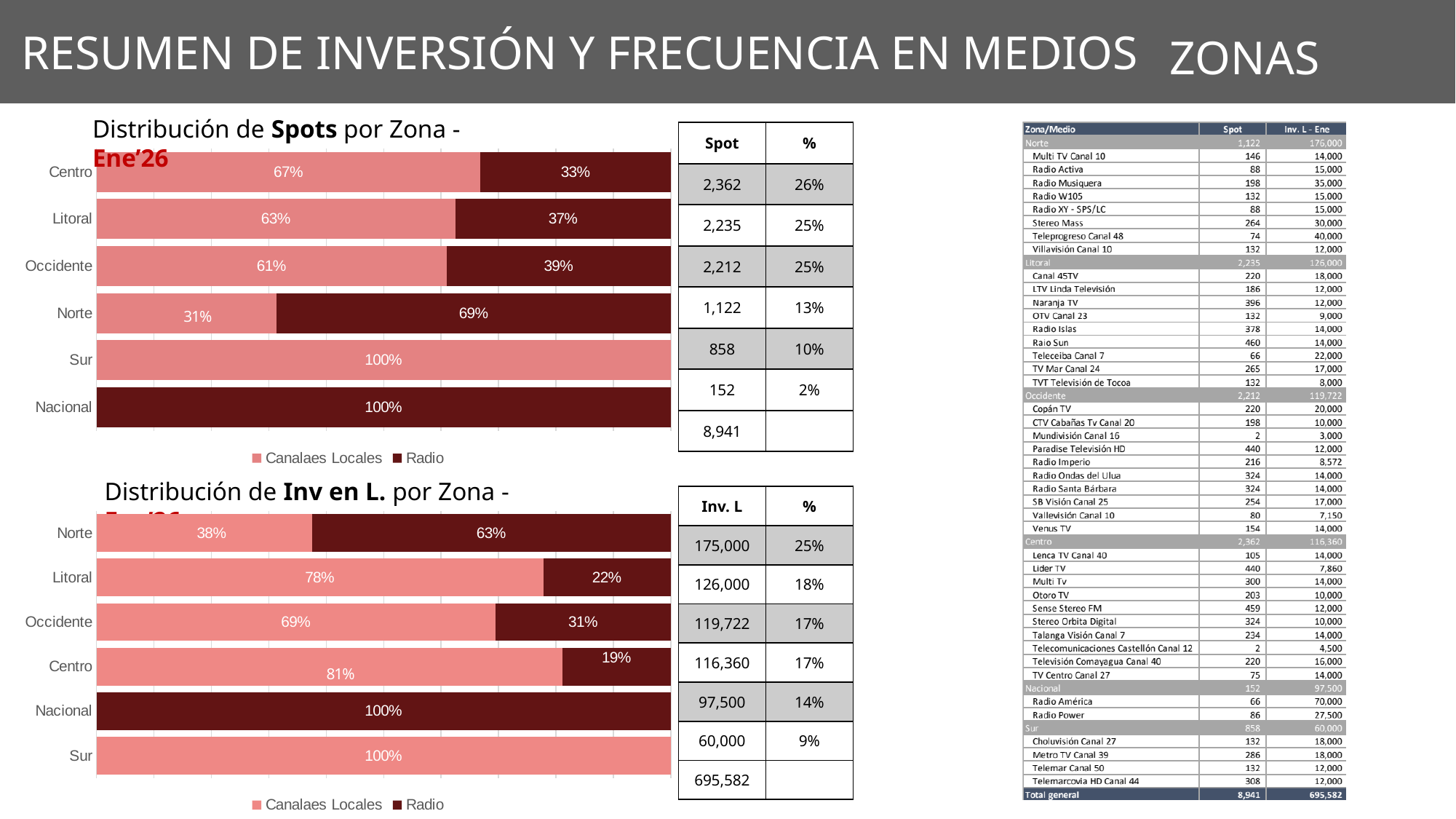
How many zones are shown in the 'Distribución de Spots por Zona' chart? 6 In the 'Distribución de Spots por Zona' chart, what is the Canalaes Locales share for Centro? 67% In the 'Distribución de Inv en L. por Zona' chart, what is the Radio share for Centro? 19% In the 'Distribución de Spots por Zona' chart, what is the difference between the Canalaes Locales share for Centro and for Litoral? 4 percentage points In the 'Distribución de Spots por Zona' chart, among Centro, Litoral, Occidente and Norte, which zone has the lowest Canalaes Locales share? Norte In the 'Distribución de Inv en L. por Zona' chart, which has the larger Radio share, Norte or Occidente? Norte In the 'Distribución de Spots por Zona' chart, what is the Radio share for Norte? 69% In the 'Distribución de Inv en L. por Zona' chart, what is the Canalaes Locales share for Norte? 38% What kind of chart is the 'Distribución de Inv en L. por Zona' chart? Stacked bar chart What are the two legend entries in the 'Distribución de Spots por Zona' chart? Canalaes Locales and Radio How many series does the legend of the 'Distribución de Spots por Zona' chart list? 2 In the 'Distribución de Inv en L. por Zona' chart, what is the Canalaes Locales share for Litoral? 78%